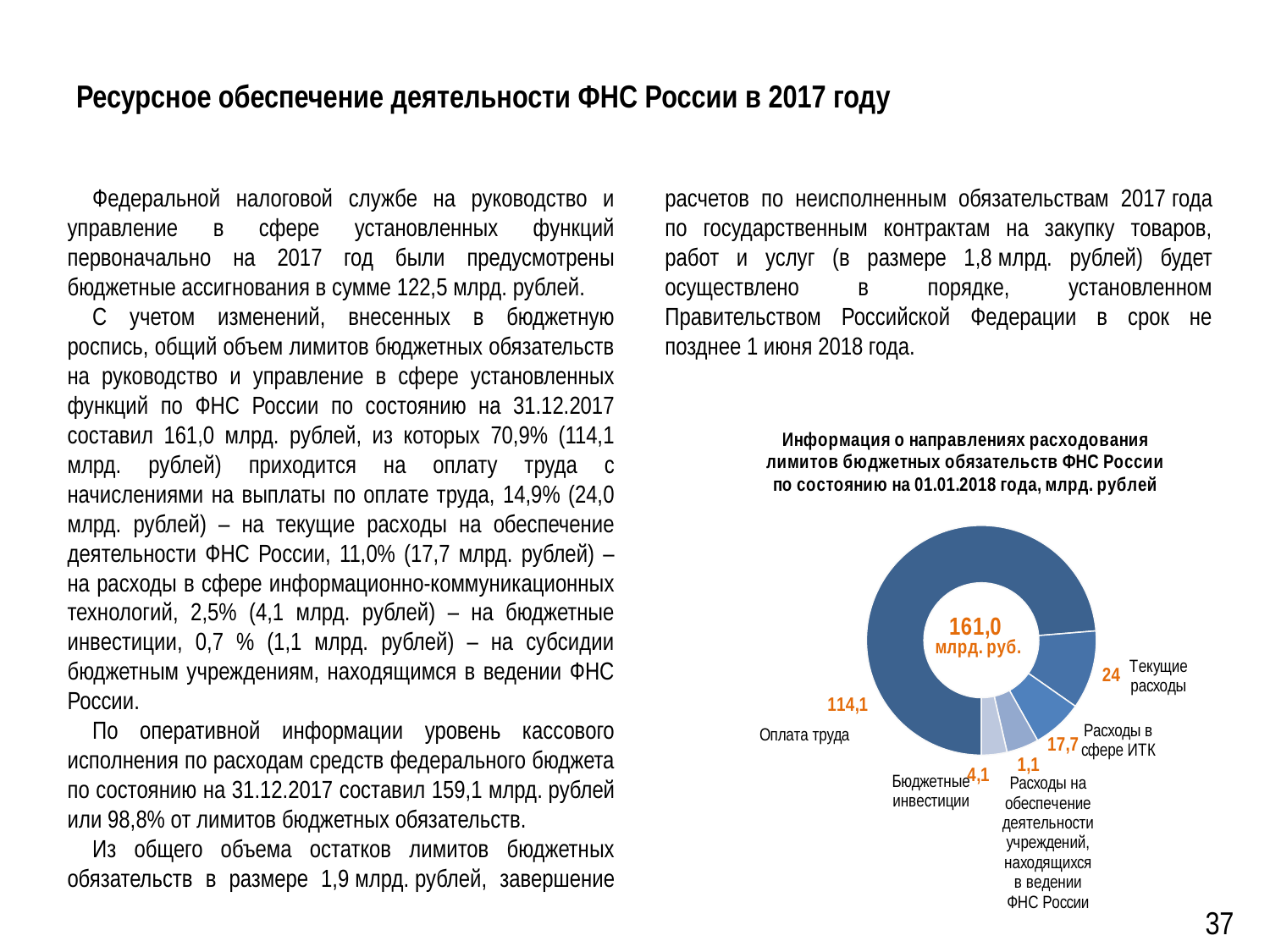
What value is shown for Расходы в сфере ИТК in the chart? 17,7 What total value is shown in the centre of the chart? 161,0 млрд. руб. What value is shown for Оплата труда in the doughnut chart? 114,1 What is the difference between the values for Текущие расходы and Расходы в сфере ИТК? 6,3 How many categories are shown in the chart? 5 Which category has the smallest slice in the chart? Расходы на обеспечение деятельности учреждений, находящихся в ведении ФНС России Which category has the largest slice in the chart? Оплата труда What kind of chart is shown on the slide? doughnut chart What value is shown for Текущие расходы in the chart? 24 What is the difference between the values for Оплата труда and Текущие расходы? 90,1 Which is larger in the chart: Бюджетные инвестиции or Расходы в сфере ИТК? Расходы в сфере ИТК What value is shown for Бюджетные инвестиции in the chart? 4,1